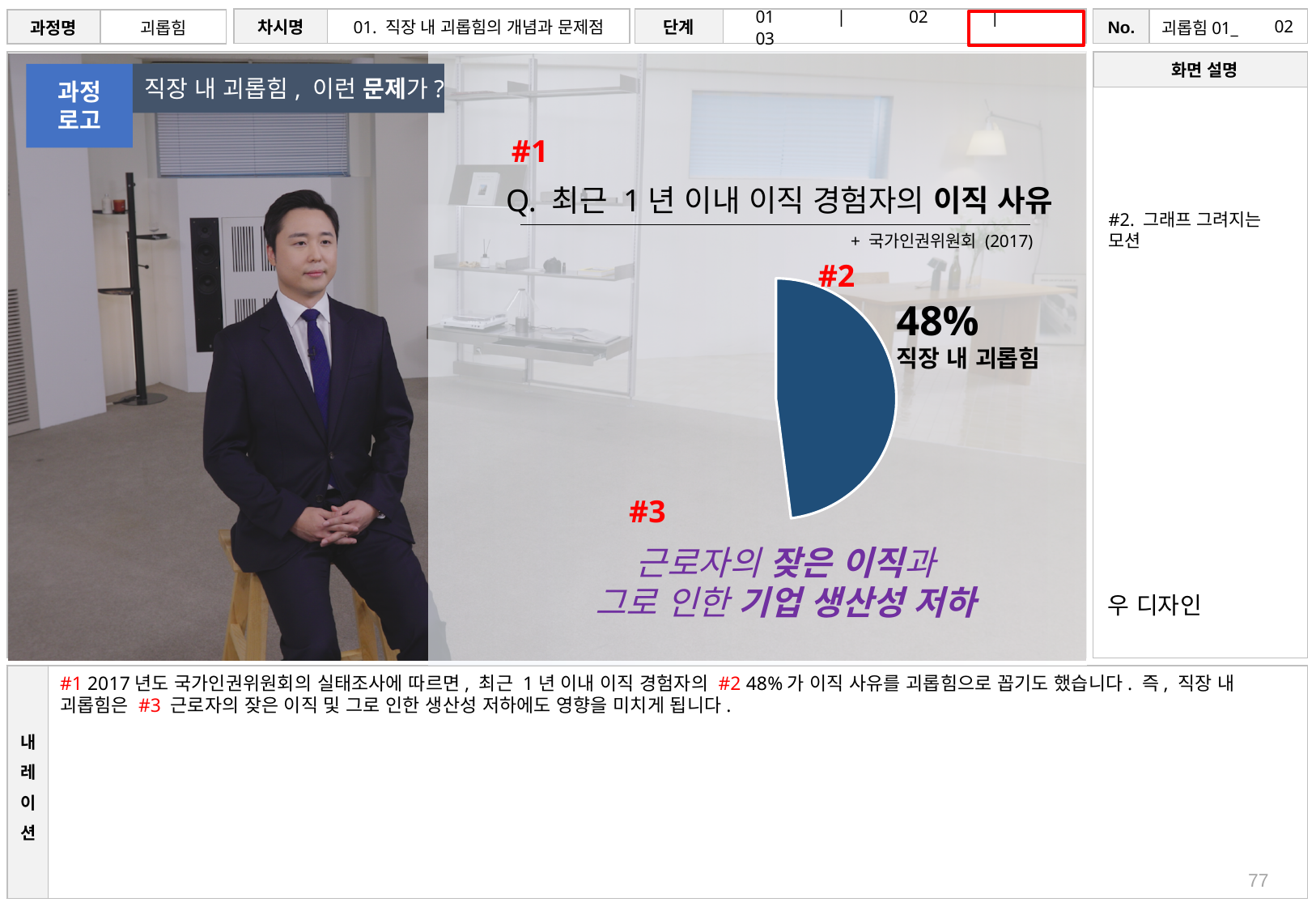
What question does the chart title ask? Q. 최근 1년 이내 이직 경험자의 이직 사유 What kind of chart is used to show the 48% figure? pie chart What source is cited for the chart data? 국가인권위원회 (2017) What percentage is shown for 직장 내 괴롭힘 on the pie chart? 48% Is the value for 직장 내 괴롭힘 greater or less than 50%? less What share of the pie does the 직장 내 괴롭힘 slice represent? 48% Which category is labelled on the pie chart slice? 직장 내 괴롭힘